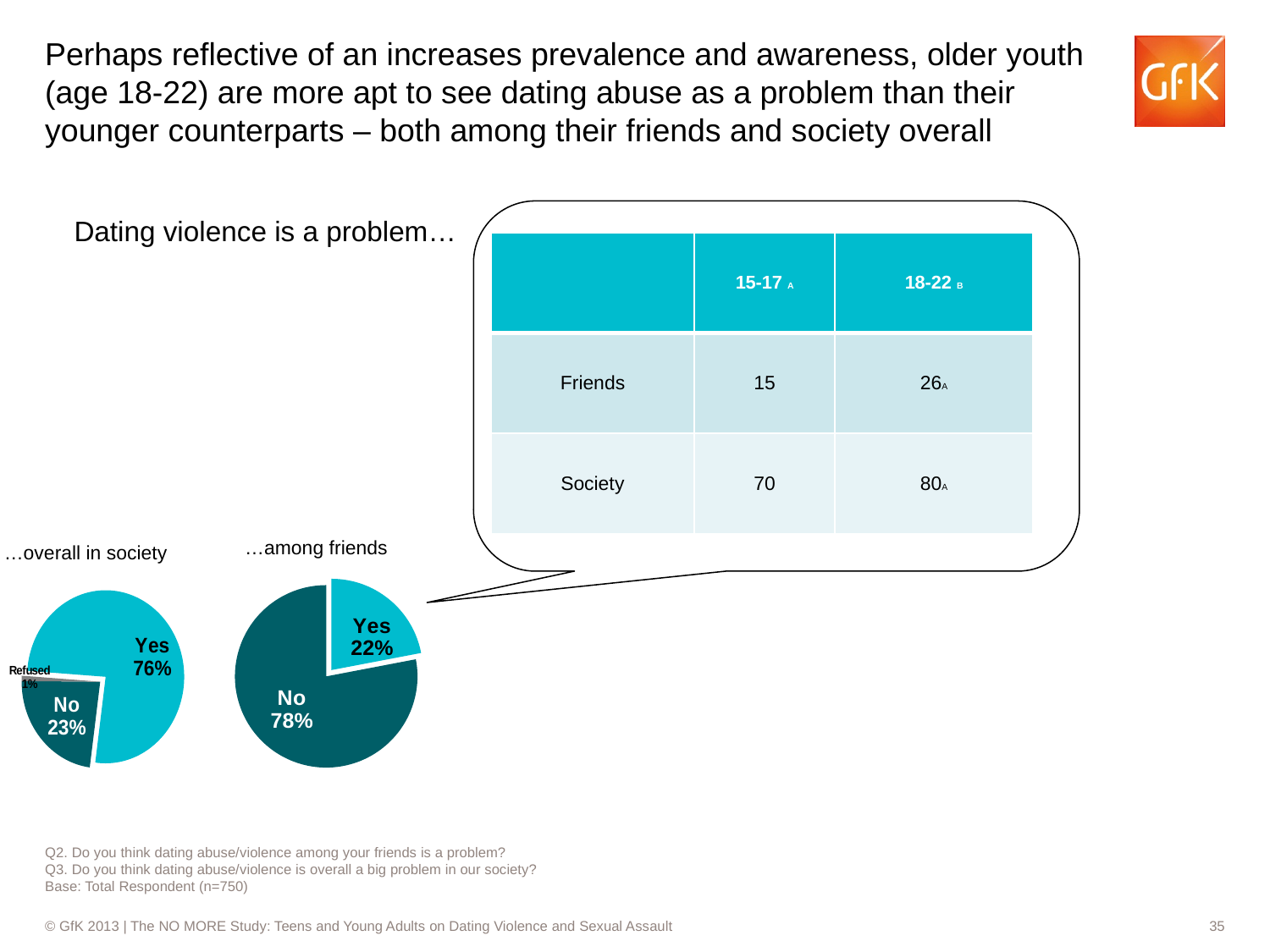
In the '...overall in society' pie chart, what share of respondents answered No? 23% How many slices does the '...among friends' pie chart have? 2 In the '...overall in society' pie chart, which slice is the smallest? Refused In the '...among friends' pie chart, what share of respondents answered No? 78% In the '...overall in society' pie chart, what share of respondents answered Yes? 76% In the '...among friends' pie chart, what is the difference between the No share and the Yes share? 56% In the '...overall in society' pie chart, what share of respondents Refused? 1% What type of chart is used for '...among friends'? Pie chart How many slices does the '...overall in society' pie chart have? 3 Which is larger: the Yes share in the '...overall in society' pie chart or the Yes share in the '...among friends' pie chart? ...overall in society In the '...among friends' pie chart, what share of respondents answered Yes? 22% In the '...among friends' pie chart, which slice is the largest? No